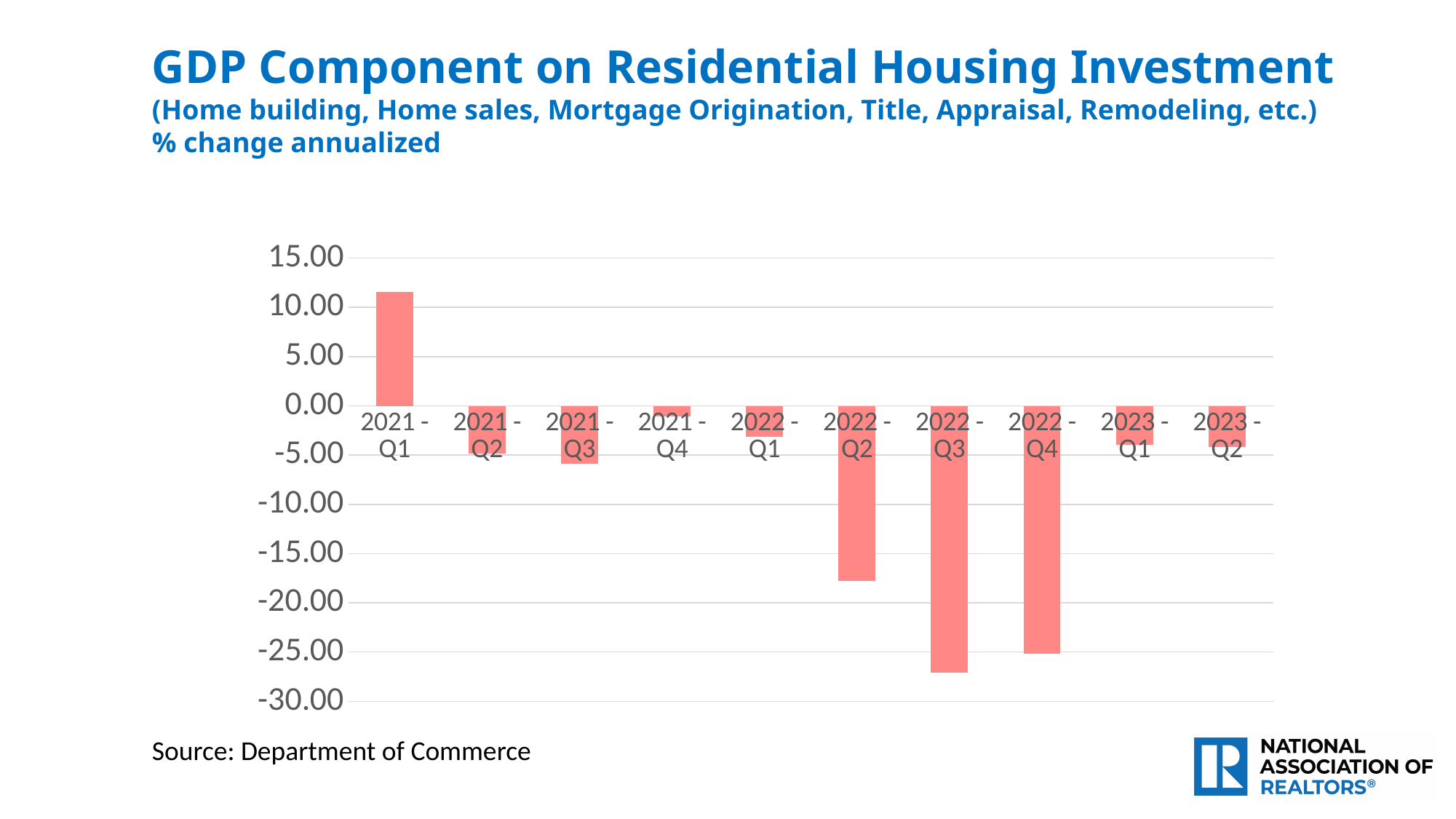
What kind of chart is shown on the slide? bar chart How many quarters are plotted on the chart? 10 Which is larger, the value for 2022 - Q2 or the value for 2022 - Q4? 2022 - Q2 Which quarter has the lowest value on the chart? 2022 - Q3 Is the value for 2021 - Q4 greater or less than -5.00? greater Which quarter is the only one with a positive value on the chart? 2021 - Q1 Is the value for 2021 - Q1 greater or less than 10.00? greater What is the source cited for the chart? Department of Commerce Is the value for 2022 - Q2 greater or less than -15.00? less Which quarter has the highest value on the chart? 2021 - Q1 Which is larger, the value for 2021 - Q4 or the value for 2021 - Q3? 2021 - Q4